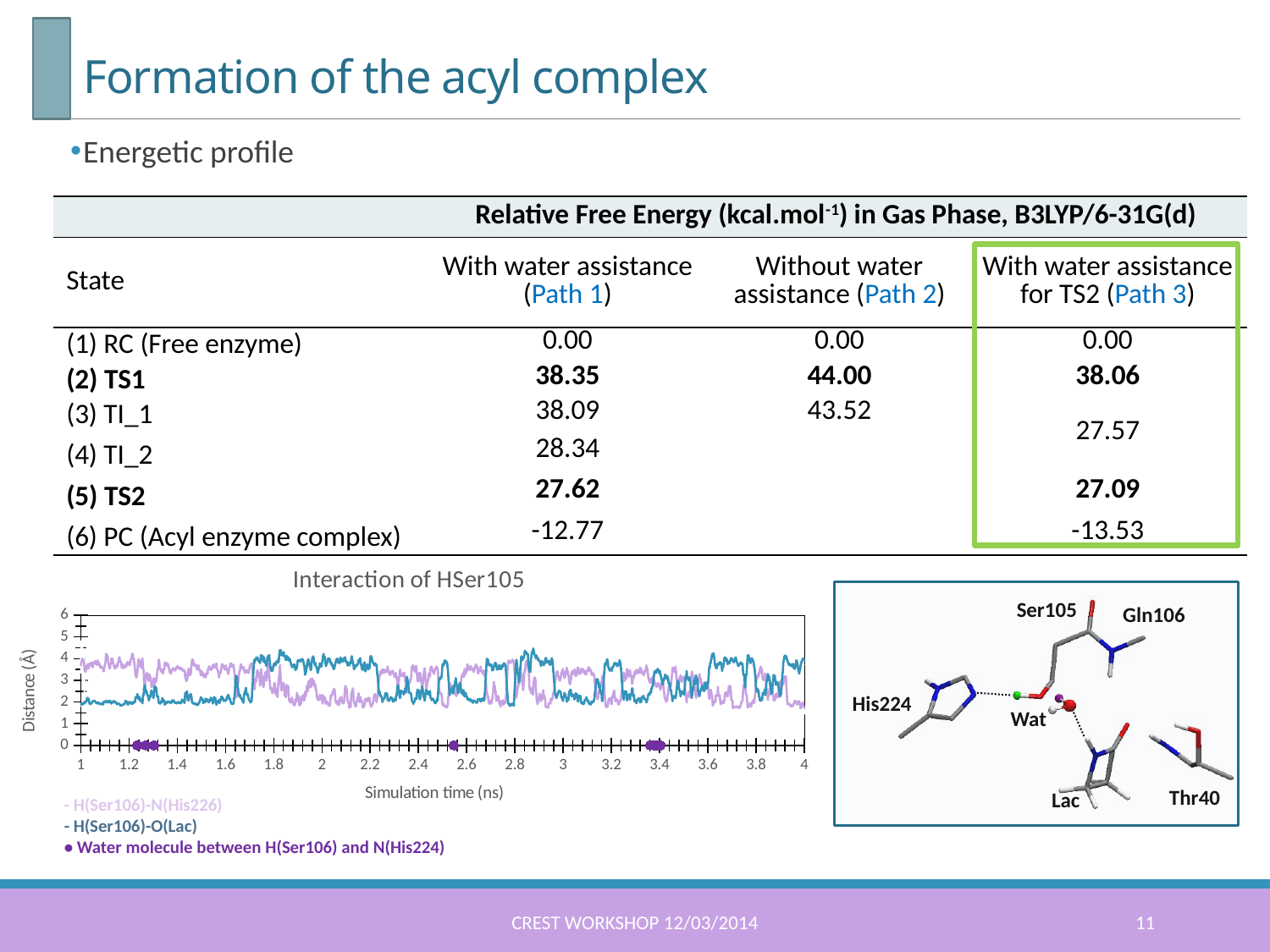
In the "Interaction of HSer105" chart, what is the highest value shown on the y axis? 6 How many labelled tick values are there on the x axis of the "Interaction of HSer105" chart? 16 In the "Interaction of HSer105" chart, what is the last value labelled on the x axis? 4 In the "Interaction of HSer105" chart, is the largest distance plotted for H(Ser106)-O(Lac) greater or less than 6? less How many labelled tick values are there on the y axis of the "Interaction of HSer105" chart? 7 How many entries does the legend of the "Interaction of HSer105" chart list? 3 What kind of chart is the "Interaction of HSer105" chart? line chart In the "Interaction of HSer105" chart, what is the first value labelled on the x axis? 1 What is the title of the chart at the bottom left of the slide? Interaction of HSer105 What is the label of the x axis of the "Interaction of HSer105" chart? Simulation time (ns)